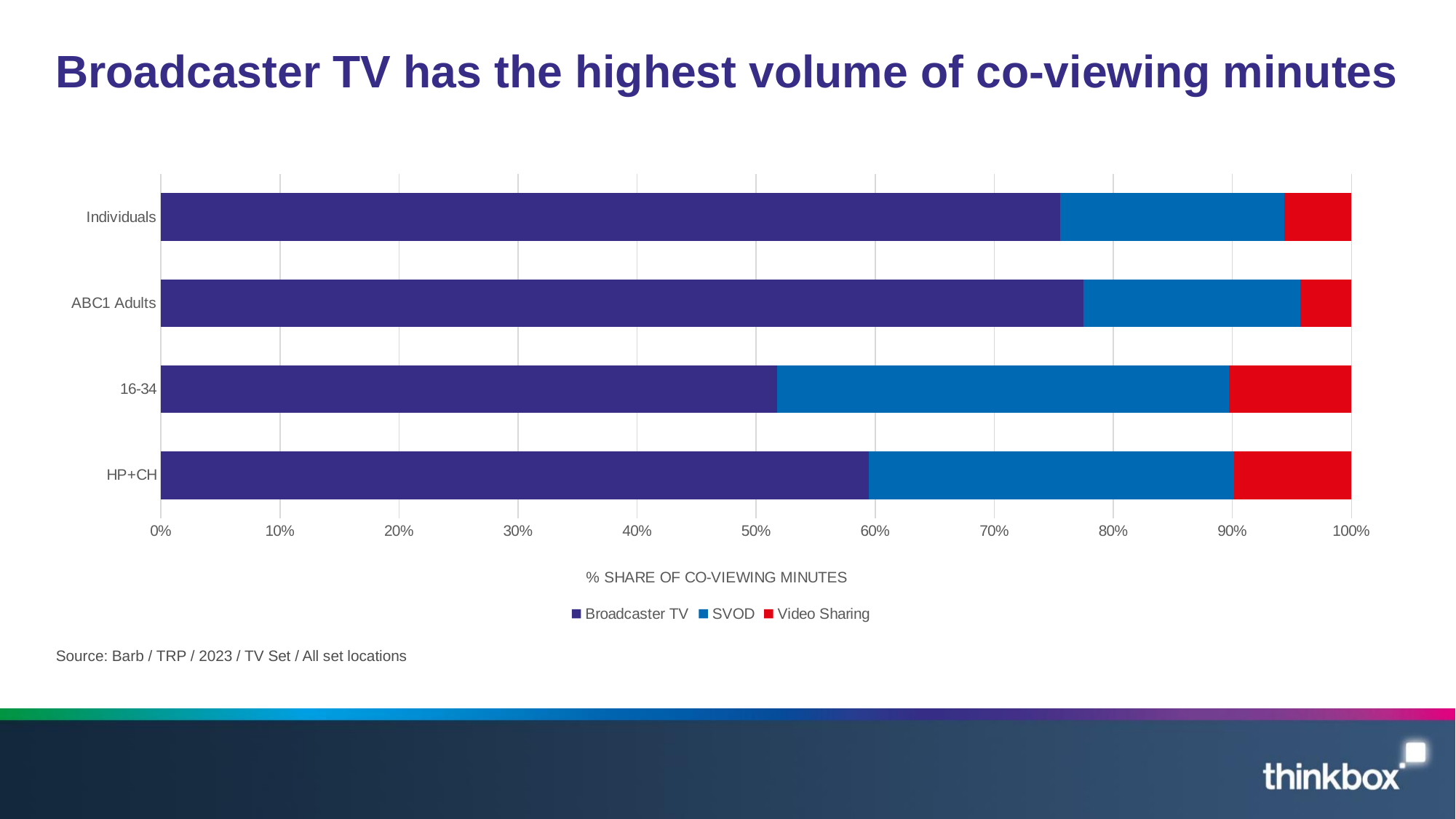
What kind of chart is shown on the slide? Stacked bar chart What is the total of the stacked bar for Individuals? 100% Is the Broadcaster TV share for HP+CH greater or less than 50%? greater How many series does the legend list? 3 Which category has the largest Broadcaster TV share of co-viewing minutes? ABC1 Adults Which has the larger Video Sharing share: 16-34 or ABC1 Adults? 16-34 What is the label on the horizontal axis of the chart? % SHARE OF CO-VIEWING MINUTES How many audience categories are plotted on the chart? 4 Which has the larger Broadcaster TV share: 16-34 or HP+CH? HP+CH Is the Broadcaster TV share for ABC1 Adults greater or less than 70%? greater Is the Broadcaster TV share for 16-34 greater or less than 60%? less Which category has the smallest Broadcaster TV share of co-viewing minutes? 16-34